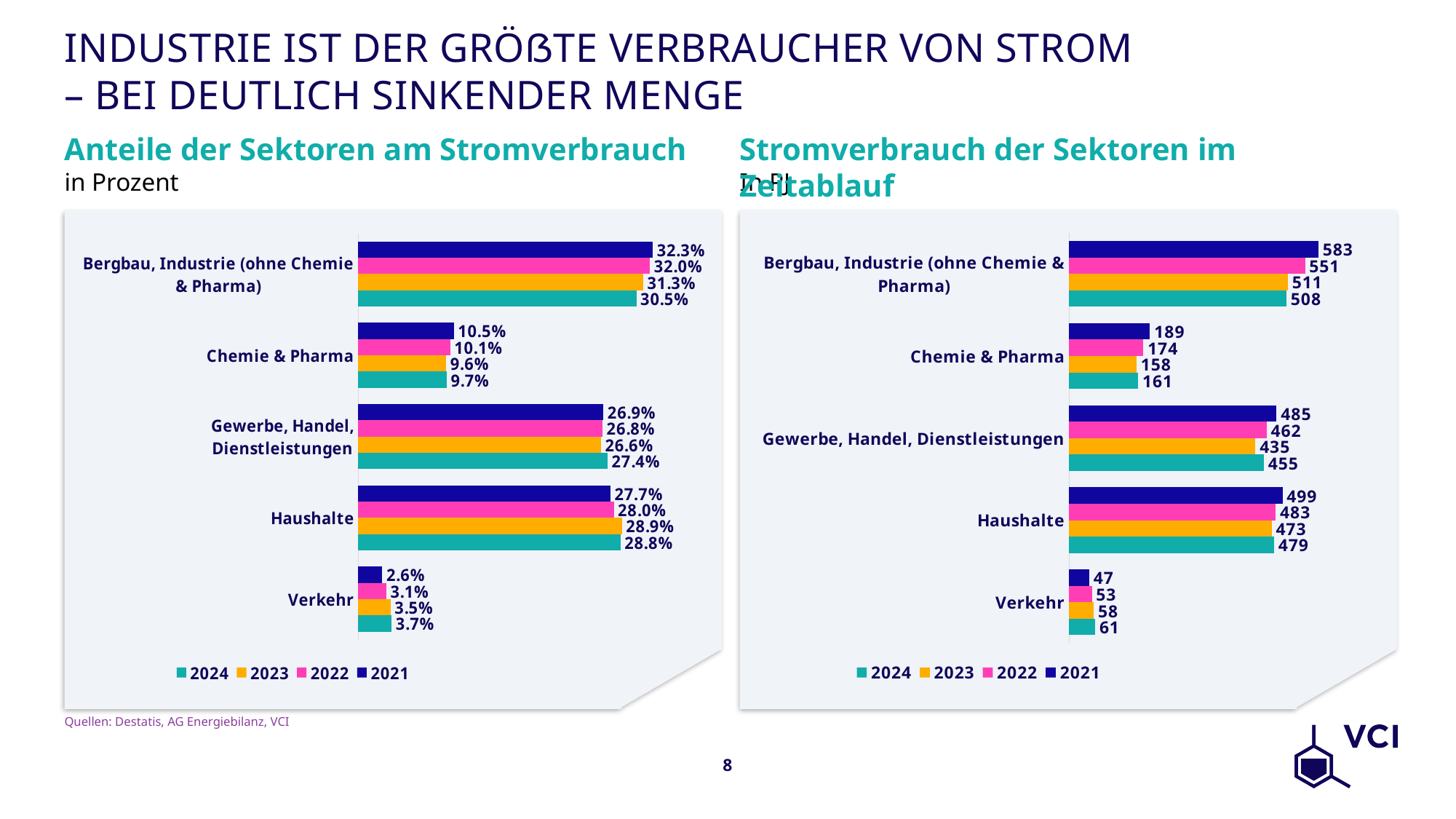
In the right chart 'Stromverbrauch der Sektoren im Zeitablauf', what is the 2021 value for Bergbau, Industrie (ohne Chemie & Pharma)? 583 In the right chart 'Stromverbrauch der Sektoren im Zeitablauf', what is the difference between the 2021 and 2024 values for Bergbau, Industrie (ohne Chemie & Pharma)? 75 How many sectors are shown in the left chart 'Anteile der Sektoren am Stromverbrauch'? 5 In the left chart 'Anteile der Sektoren am Stromverbrauch', what is the 2024 share for Chemie & Pharma? 9.7% In the right chart 'Stromverbrauch der Sektoren im Zeitablauf', which sector has the highest 2021 value? Bergbau, Industrie (ohne Chemie & Pharma) How many series does the legend of the right chart 'Stromverbrauch der Sektoren im Zeitablauf' list? 4 In the right chart 'Stromverbrauch der Sektoren im Zeitablauf', which is larger for 2024: Haushalte or Gewerbe, Handel, Dienstleistungen? Haushalte What kind of chart is the right chart 'Stromverbrauch der Sektoren im Zeitablauf'? Bar chart In the right chart 'Stromverbrauch der Sektoren im Zeitablauf', what is the 2023 value for Haushalte? 473 In the right chart 'Stromverbrauch der Sektoren im Zeitablauf', which colour represents 2024 in the legend? Teal In the left chart 'Anteile der Sektoren am Stromverbrauch', which sector has the lowest 2024 share? Verkehr In the left chart 'Anteile der Sektoren am Stromverbrauch', what is the difference between the 2024 shares of Haushalte and Gewerbe, Handel, Dienstleistungen? 1.4%